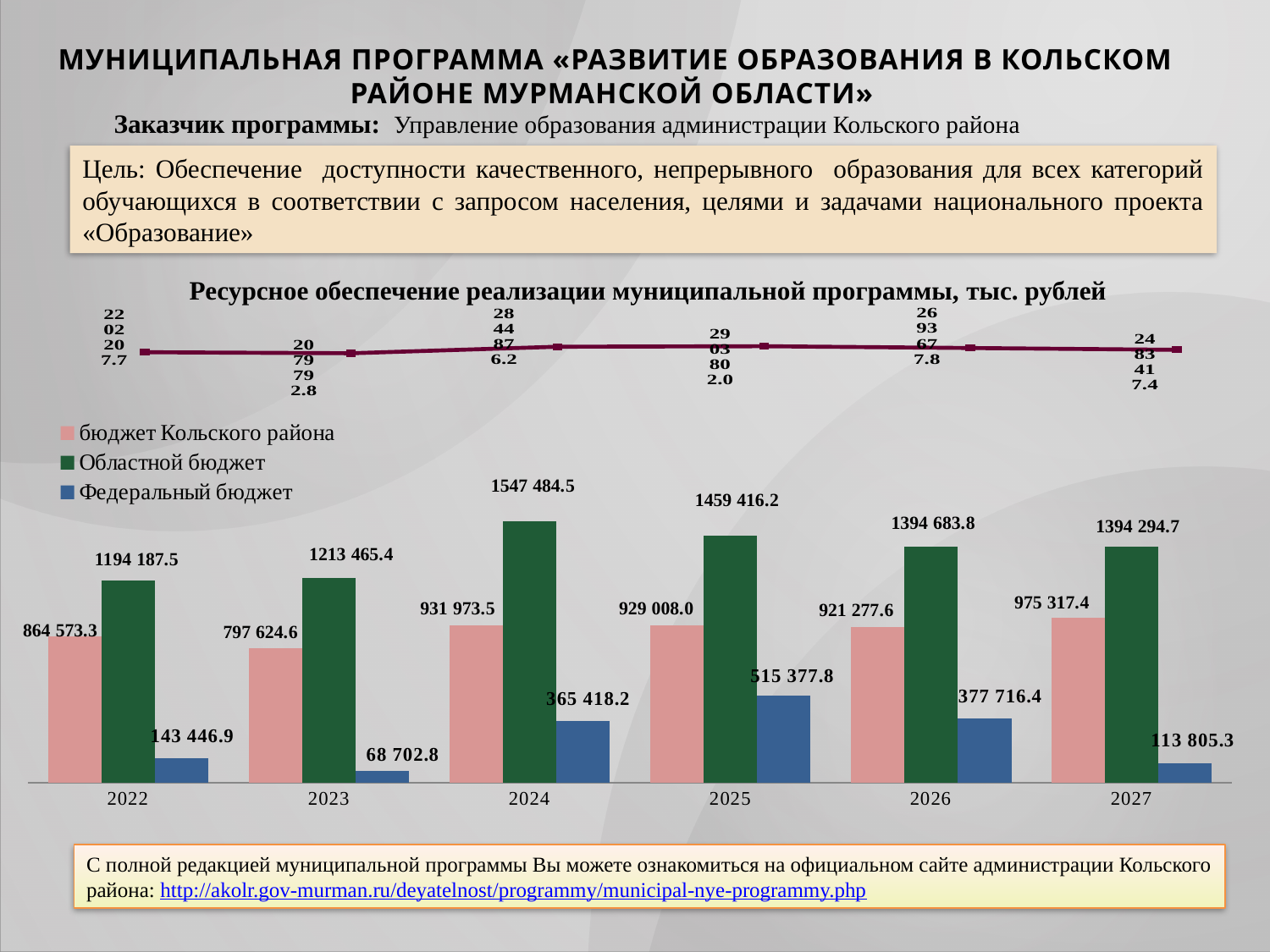
What is the value for Федеральный бюджет in 2023? 68 702.8 What kind of chart is used to show the budget values by year? bar chart How many series does the legend list? 3 In which year is Федеральный бюджет lowest? 2023 Does Областной бюджет rise or fall from 2024 to 2027? fall In which year is бюджет Кольского района highest? 2027 What is the difference between Областной бюджет and бюджет Кольского района in 2024? 615 511.0 Which is larger: Федеральный бюджет in 2022 or in 2027? 2022 What is the value for Областной бюджет in 2024? 1547 484.5 How many years are shown on the x axis of the bar chart? 6 In which year is Областной бюджет highest? 2024 What is the value for бюджет Кольского района in 2027? 975 317.4